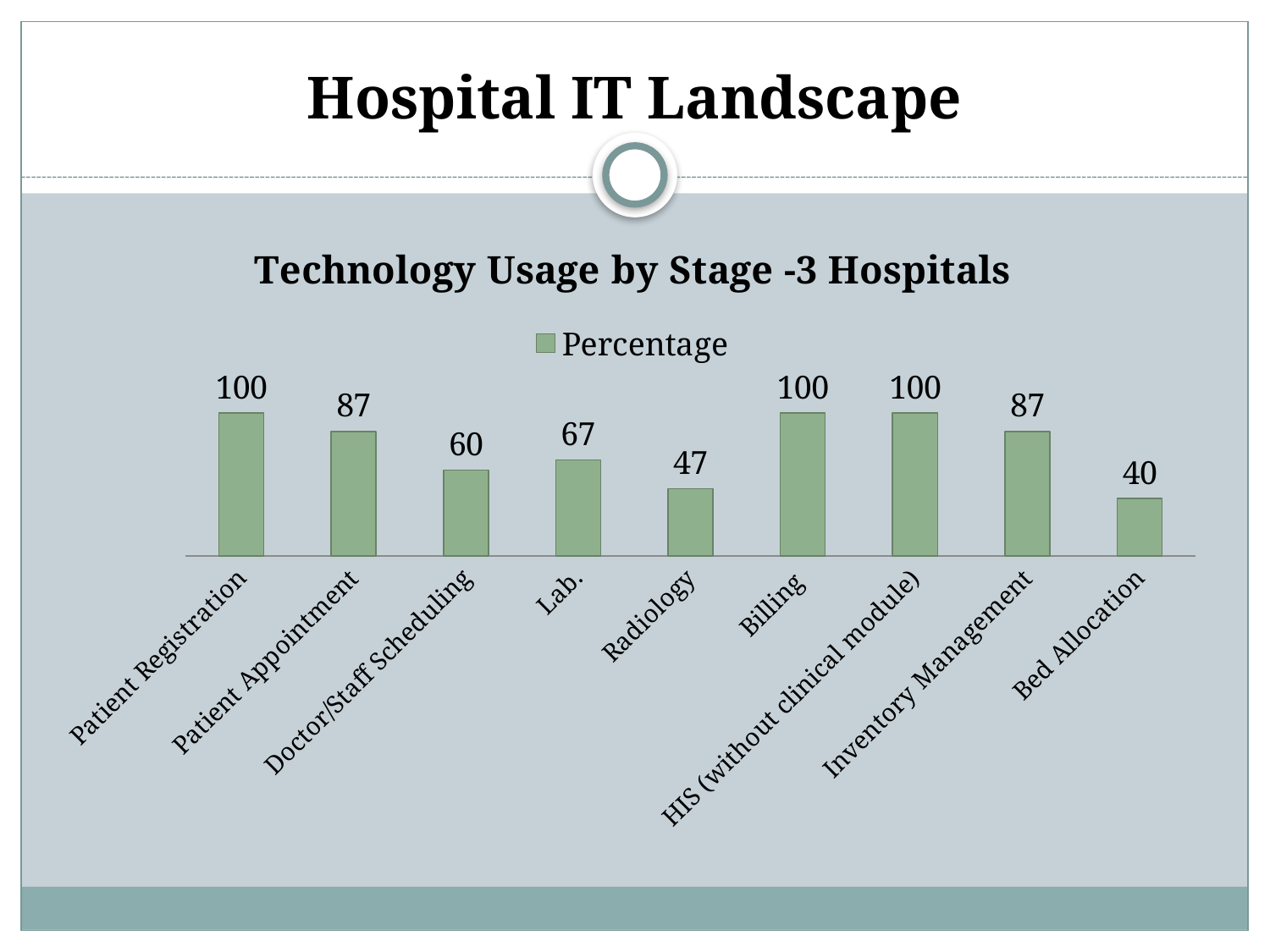
What is the value for Patient Registration? 100 What is the title of the chart? Technology Usage by Stage -3 Hospitals What is the value for Radiology? 47 Which is larger, the value for Patient Appointment or the value for Lab.? Patient Appointment How many series does the legend list? 1 What is the difference between the values for Lab. and Radiology? 20 What is the value for Doctor/Staff Scheduling? 60 What is the value for Inventory Management? 87 What is the difference between the values for Billing and Bed Allocation? 60 What kind of chart is shown on the slide? Bar chart How many categories are shown on the x axis? 9 Which category has the lowest value? Bed Allocation